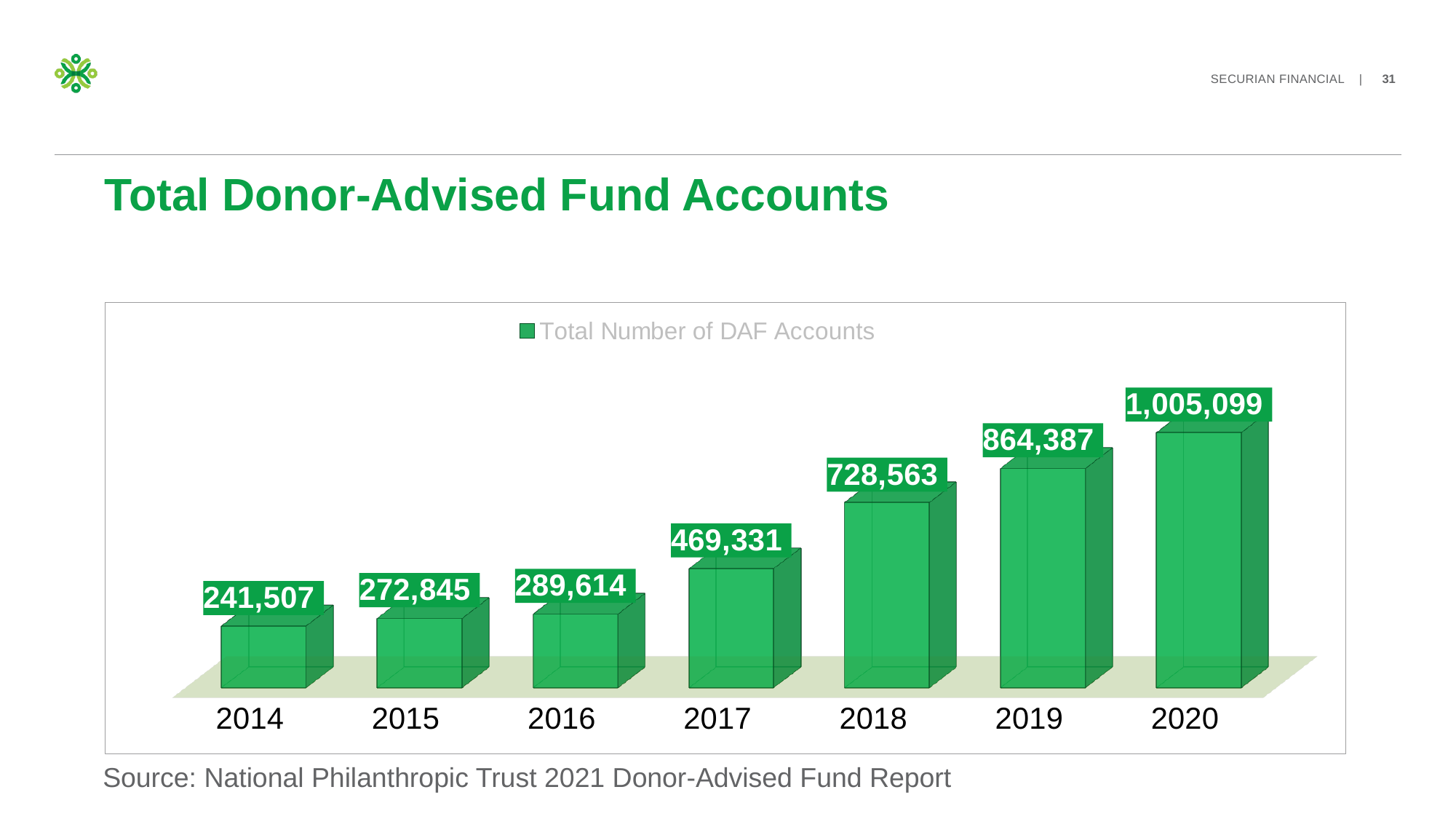
What is the difference in the total number of DAF accounts between 2018 and 2017? 259,232 How many series does the legend list? 1 Which year has the highest total number of DAF accounts? 2020 Which year has more DAF accounts, 2016 or 2018? 2018 Which year has the lowest total number of DAF accounts? 2014 What is the difference in the total number of DAF accounts between 2020 and 2019? 140,712 What is the total number of DAF accounts in 2020? 1,005,099 How many years are shown on the chart? 7 What is the total number of DAF accounts in 2017? 469,331 What kind of chart is shown on the slide? Bar chart Do the values rise or fall from 2014 to 2020? Rise What is the total number of DAF accounts in 2014? 241,507